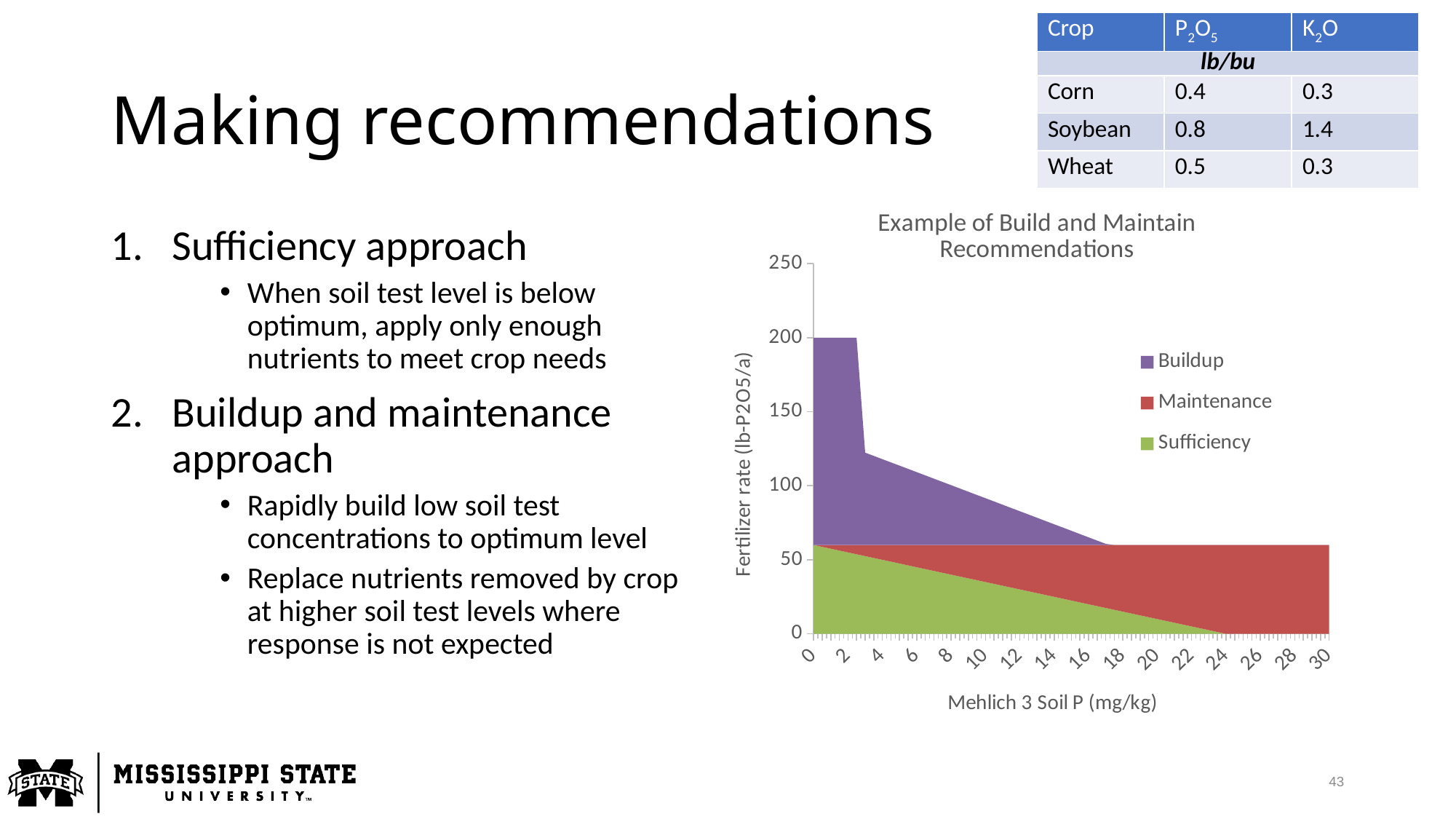
Is the top of the Sufficiency area at Mehlich 3 Soil P of 20 greater or less than 50? less Does the Buildup series rise or fall as Mehlich 3 Soil P increases from 0 to 18? Fall What is the highest value shown on the chart's y axis? 250 How many tick labels are shown on the chart's x axis? 16 Which series in the chart is shown in purple? Buildup Is the top of the Buildup area at Mehlich 3 Soil P of 0 greater or less than 150? greater Is the top of the Maintenance area at Mehlich 3 Soil P of 30 greater or less than 100? less What is the title of the chart? Example of Build and Maintain Recommendations How many series does the chart legend list? 3 What kind of chart is shown on the slide? Area chart Does the Sufficiency series rise or fall as Mehlich 3 Soil P increases from 0 to 24? Fall